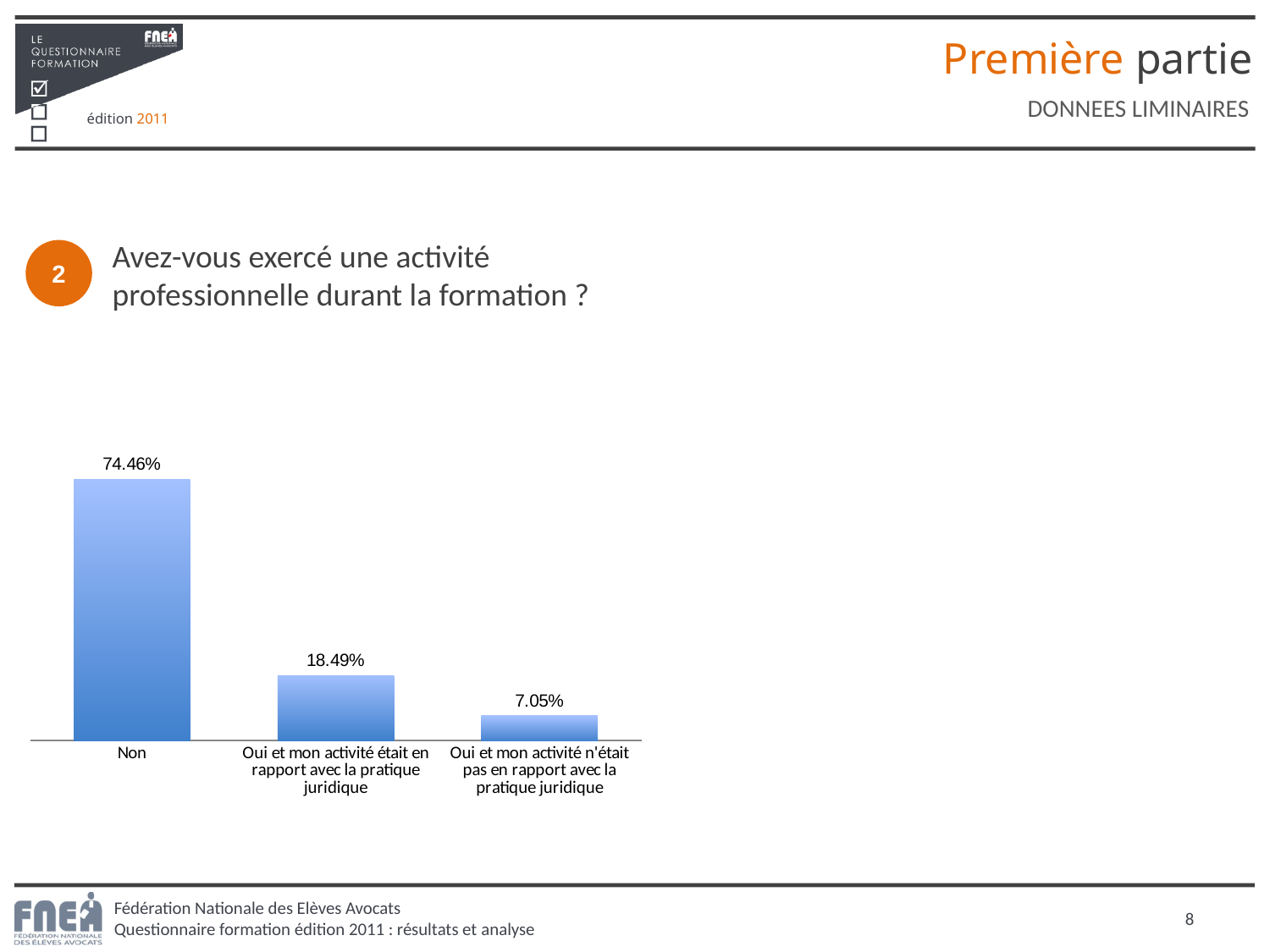
Which category has the lowest value? Oui et mon activité n'était pas en rapport avec la pratique juridique What is the value for "Oui et mon activité n'était pas en rapport avec la pratique juridique"? 7.05% What is the difference between the value for "Non" and the value for "Oui et mon activité était en rapport avec la pratique juridique"? 55.97% How many categories are shown in the chart? 3 What is the difference between the values for the two "Oui" categories? 11.44% Which category has the highest value? Non Which is larger: the value for "Oui et mon activité était en rapport avec la pratique juridique" or the value for "Oui et mon activité n'était pas en rapport avec la pratique juridique"? Oui et mon activité était en rapport avec la pratique juridique What is the value for "Oui et mon activité était en rapport avec la pratique juridique"? 18.49% What is the value for "Non"? 74.46% Do the values rise or fall from left to right along the x axis? Fall What kind of chart is shown on the slide? Bar chart What question does the chart on the slide answer? Avez-vous exercé une activité professionnelle durant la formation ?